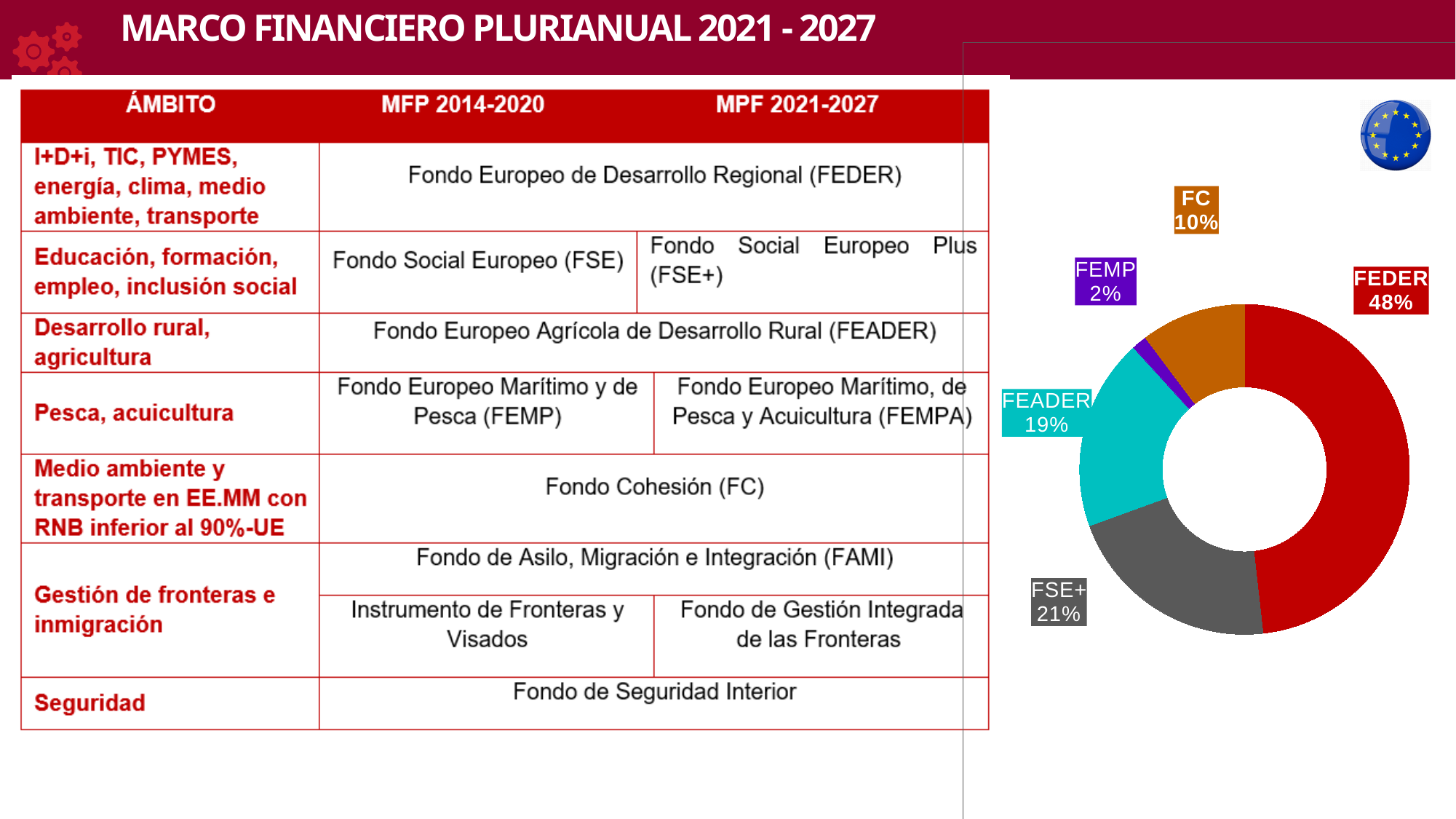
What share of the doughnut chart does FEDER represent? 48% What share of the doughnut chart does FSE+ represent? 21% What share of the doughnut chart does FC represent? 10% Which fund has the largest share in the doughnut chart? FEDER How many funds are shown as slices in the doughnut chart? 5 Which fund has the smallest share in the doughnut chart? FEMP Which has a larger share, FC or FEADER? FEADER What is the difference in percentage points between the FEDER share and the FSE+ share? 27 What is the difference in percentage points between the FSE+ share and the FEADER share? 2 What type of chart is shown on the right of the slide? Doughnut (pie) chart